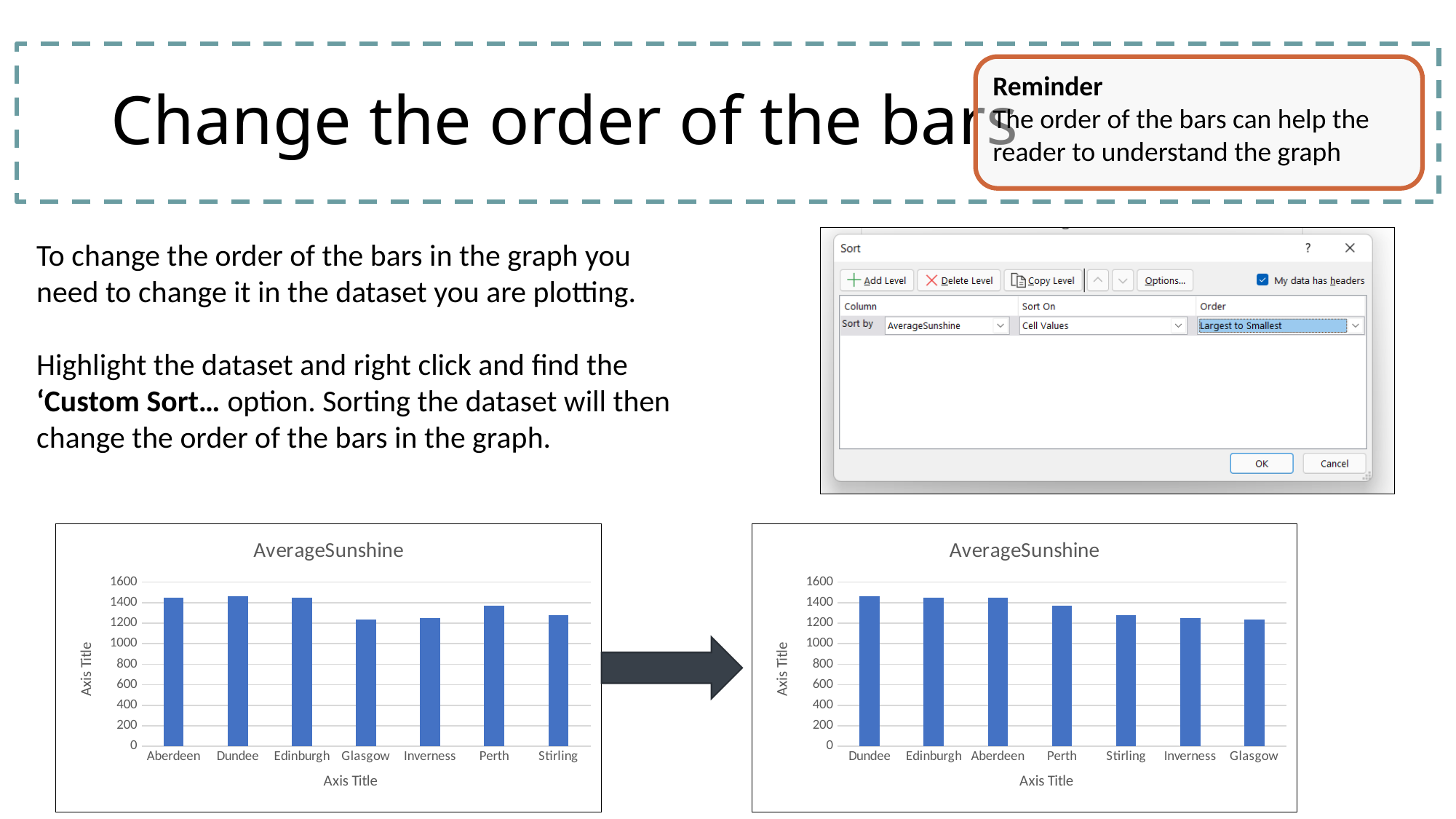
On the left AverageSunshine chart, which is larger, the value for Perth or the value for Glasgow? Perth On the right AverageSunshine chart, which is larger, the value for Dundee or the value for Stirling? Dundee On the right AverageSunshine chart, do the bar values rise or fall from left to right along the x axis? fall On the right AverageSunshine chart, is the value for Inverness greater or less than 1000? greater On the left AverageSunshine chart, is the value for Perth greater or less than 1200? greater Which category appears first on the x axis of the right AverageSunshine chart? Dundee How many categories are shown on the left AverageSunshine chart? 7 On the left AverageSunshine chart, is the value for Glasgow greater or less than 1400? less What is the label on the vertical axis of the left chart? Axis Title What kind of chart is the left chart titled AverageSunshine? bar chart